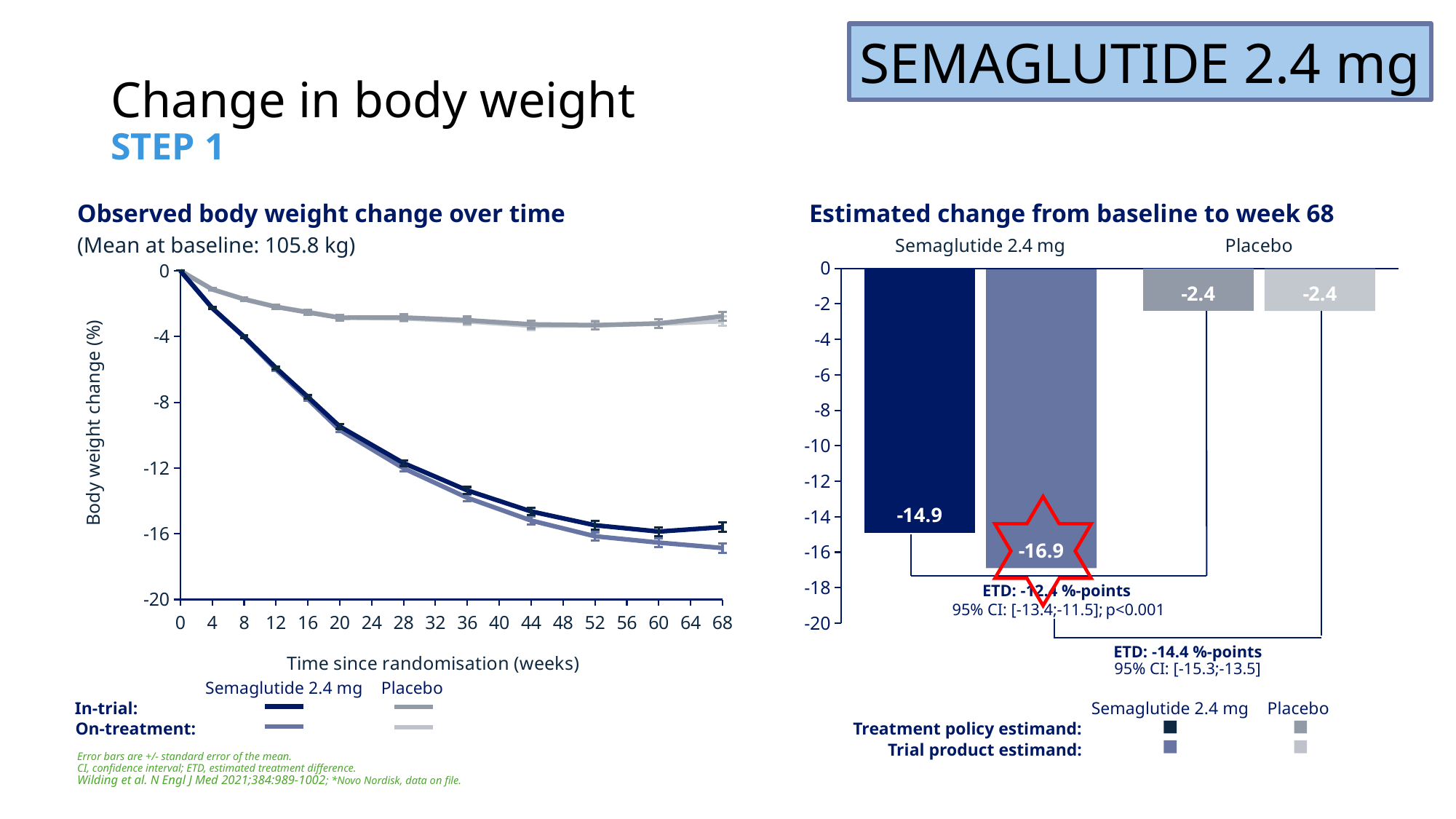
In the 'Estimated change from baseline to week 68' chart, what is the value for Semaglutide 2.4 mg under the treatment policy estimand? -14.9 What kind of chart is 'Estimated change from baseline to week 68'? Bar chart In the 'Estimated change from baseline to week 68' chart, what is the ETD shown for the trial product estimand comparison? -14.4 %-points In the 'Estimated change from baseline to week 68' chart, what is the 95% CI shown for the ETD of -14.4 %-points? [-15.3;-13.5] In the 'Estimated change from baseline to week 68' chart, what is the value for Placebo under the treatment policy estimand? -2.4 In the 'Observed body weight change over time' chart, what is the mean body weight at baseline stated under the title? 105.8 kg In the 'Estimated change from baseline to week 68' chart, which bar shows the largest weight reduction? Semaglutide 2.4 mg, trial product estimand (-16.9) In the 'Estimated change from baseline to week 68' chart, what is the difference between the Semaglutide 2.4 mg trial product estimand value and the treatment policy estimand value? 2.0 In the 'Observed body weight change over time' chart, is the Semaglutide 2.4 mg in-trial value at week 68 greater or less than -12? less In the 'Observed body weight change over time' chart, how many lines does the legend list? 4 In the 'Estimated change from baseline to week 68' chart, what is the value for Semaglutide 2.4 mg under the trial product estimand? -16.9 What kind of chart is 'Observed body weight change over time'? Line chart